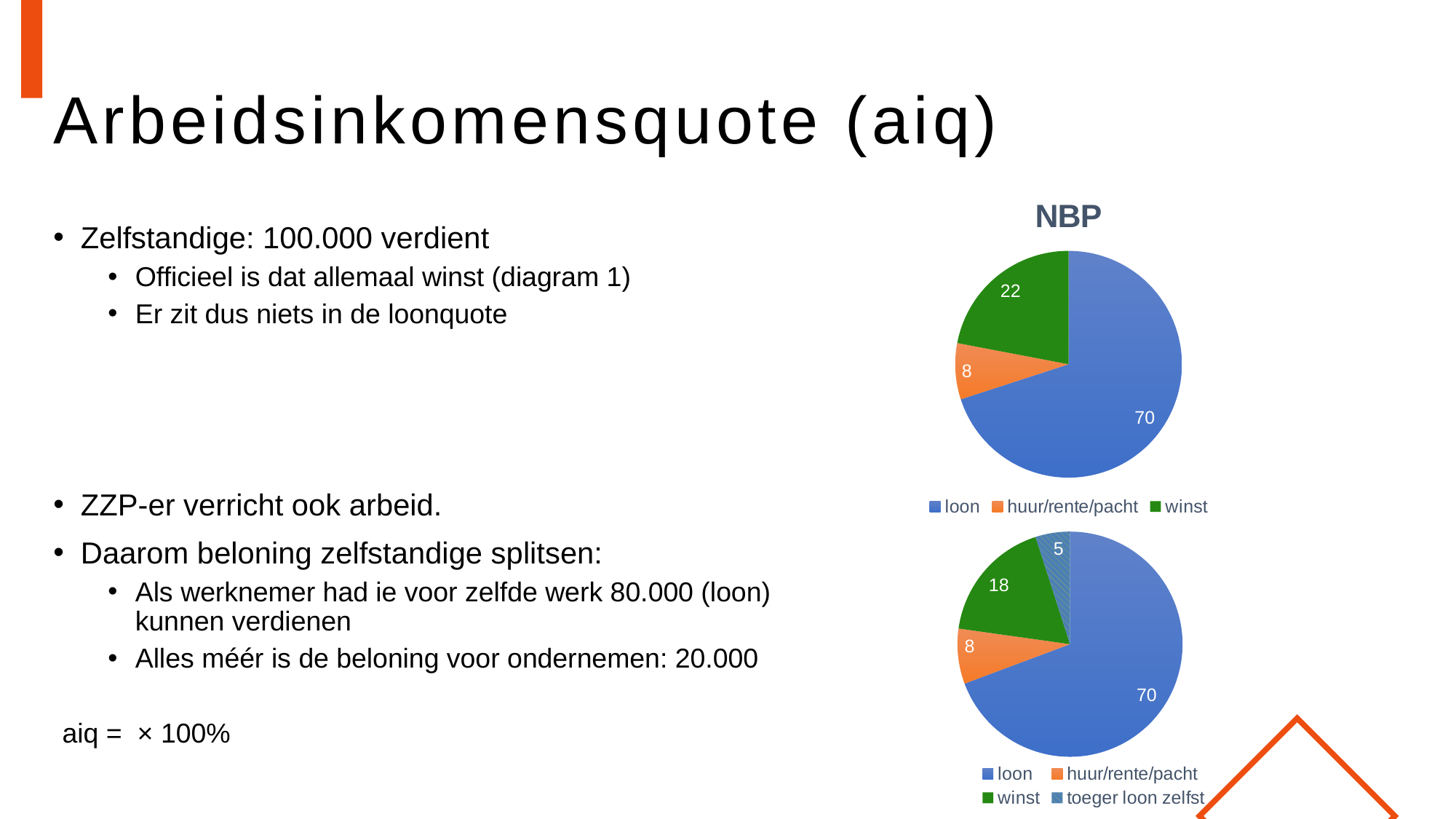
In the bottom pie chart, which category has the smallest slice? toeger loon zelfst In the top pie chart titled NBP, what share of the pie does loon represent? 70% In the top pie chart titled NBP, what is the value for loon? 70 In the top pie chart titled NBP, which category has the largest slice? loon In the top pie chart titled NBP, what is the difference between the values for winst and huur/rente/pacht? 14 In the top pie chart titled NBP, what is the value for winst? 22 What type of chart is the top chart titled NBP? pie chart How many categories does the legend of the bottom pie chart list? 4 In the bottom pie chart, which is larger, winst or huur/rente/pacht? winst In the bottom pie chart, what is the value for toeger loon zelfst? 5 In the bottom pie chart, what is the value for winst? 18 In the top pie chart titled NBP, what is the value for huur/rente/pacht? 8